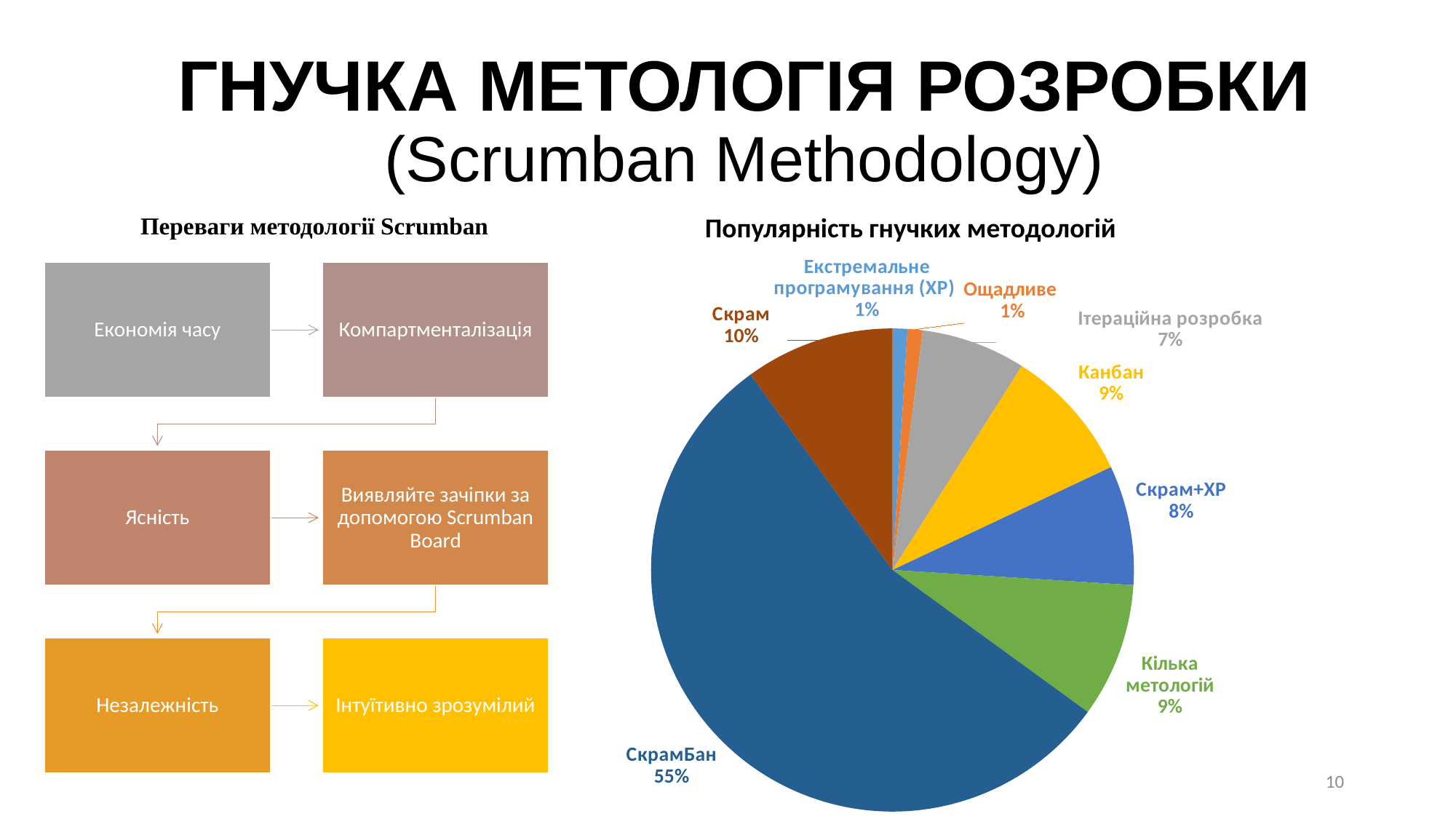
What type of chart is shown on the slide? pie chart What is the difference between the values for СкрамБан and Скрам? 45% What colour is the СкрамБан slice? blue What is the title of the chart on the slide? Популярність гнучких методологій What is the value shown for Ітераційна розробка? 7% What is the value shown for Скрам? 10% What is the value shown for Скрам+XP? 8% What share of the pie does СкрамБан have? 55% What is the value shown for Канбан? 9% Which category has the largest slice of the pie? СкрамБан Which is larger, the value for Канбан or the value for Ітераційна розробка? Канбан How many slices does the pie chart have? 8